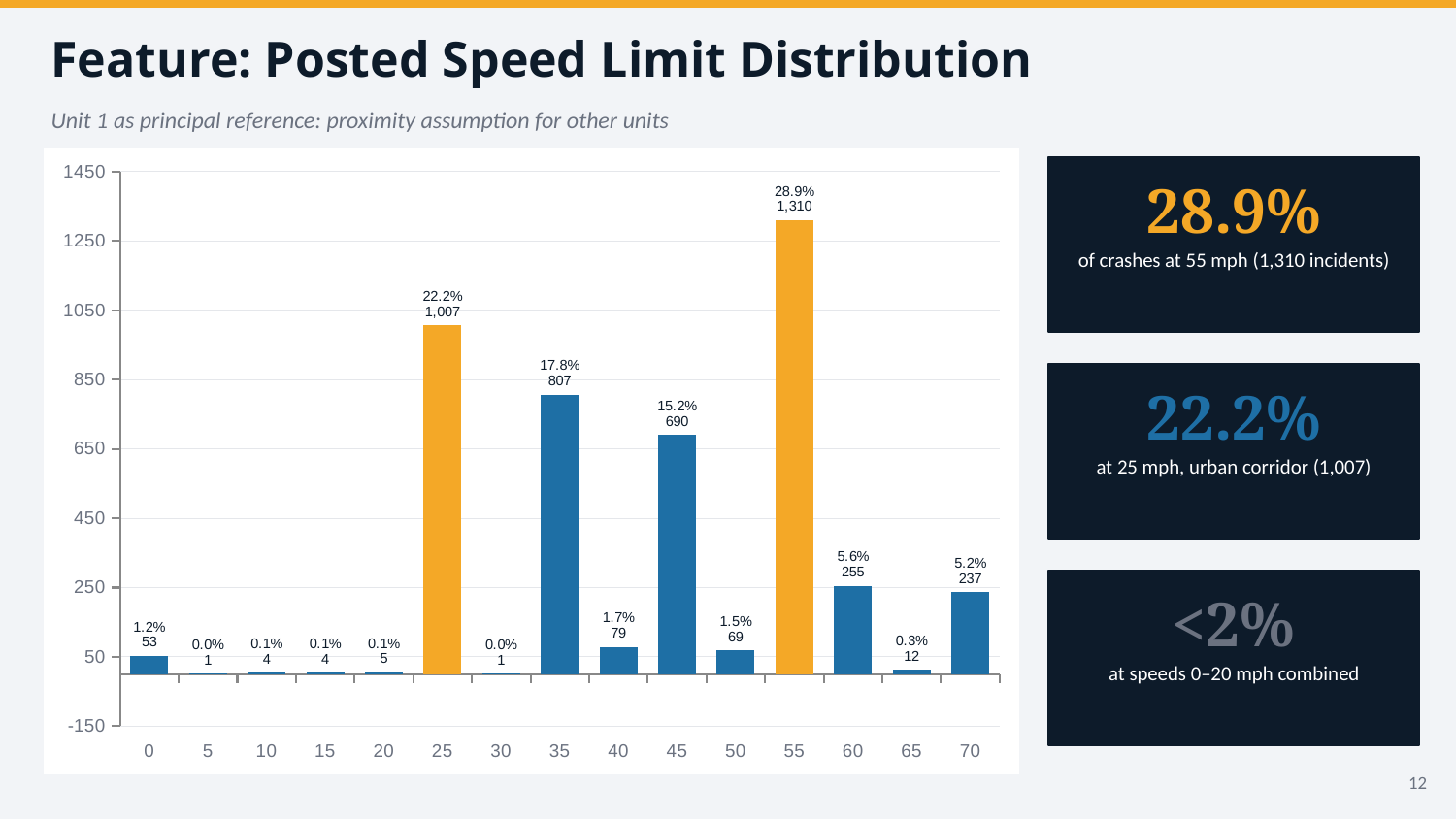
What percentage of crashes occurred at a posted speed limit of 25 mph? 22.2% What is the number of crashes at a posted speed limit of 45 mph? 690 Which posted speed limit has the highest number of crashes? 55 What kind of chart is shown on the slide? Bar chart Which bars in the chart are highlighted in orange rather than blue? 25 and 55 Which has more crashes, the 35 mph or the 45 mph speed limit? 35 mph What is the difference in crash counts between the 55 mph and 25 mph speed limits? 303 What is the number of crashes at a posted speed limit of 55 mph? 1,310 How many posted speed limit categories are shown on the x axis? 15 Is the value for the 35 mph speed limit greater or less than 650? greater What is the total number of crashes at the 60 mph and 70 mph speed limits combined? 492 What percentage of crashes occurred at a posted speed limit of 60 mph? 5.6%